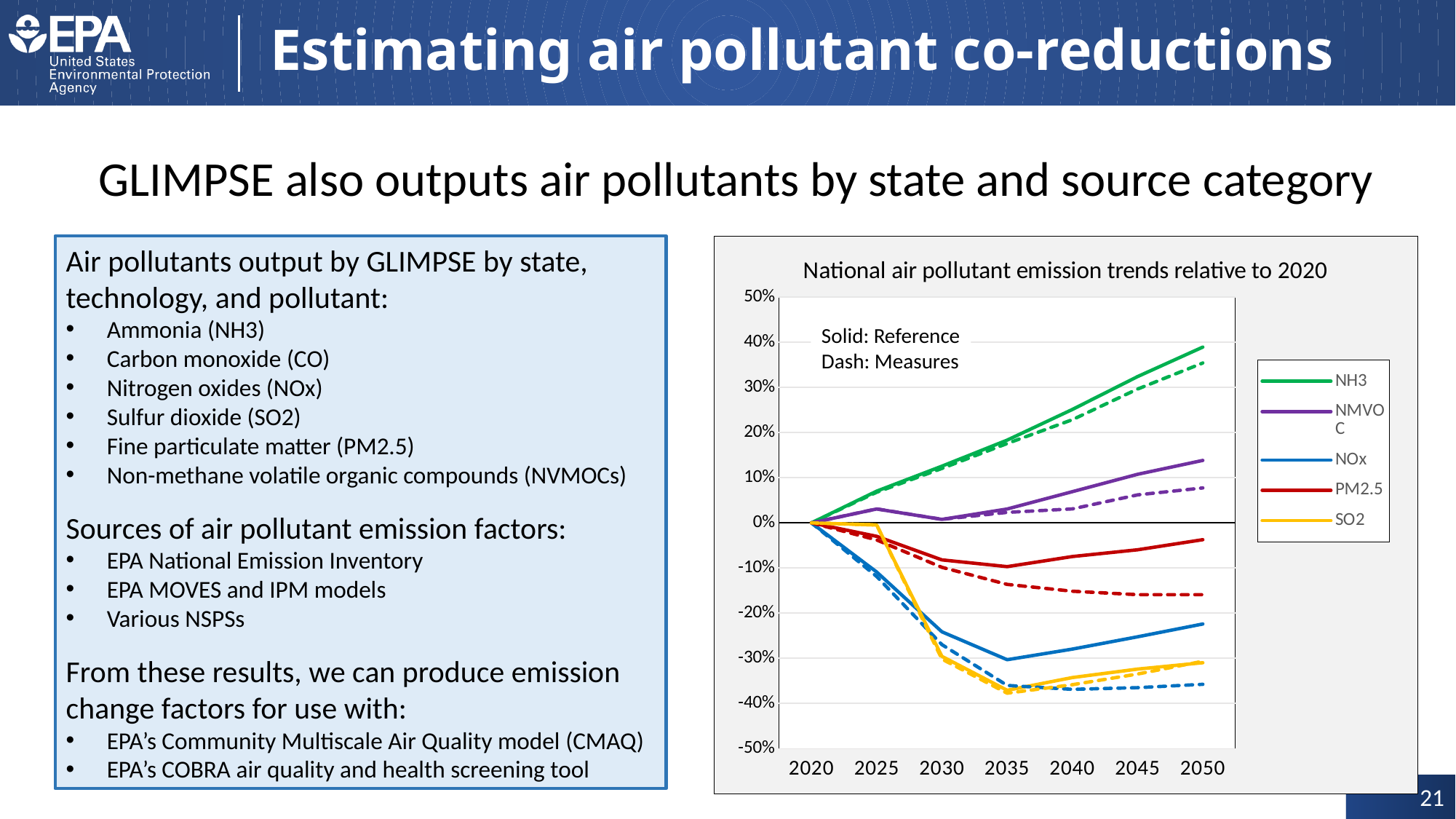
Does the solid NH3 line rise or fall from 2020 to 2050? Rises How many pollutants does the chart legend list? 5 Is the value of the solid PM2.5 line in 2050 greater or less than -10%? greater What kind of chart is shown on the slide? Line chart According to the chart annotation, what do the dashed lines represent? Measures Among the solid Reference lines, which pollutant has the highest value in 2050? NH3 Is the value of the solid NH3 line in 2050 greater or less than 30%? greater Is the value of the solid SO2 line in 2035 greater or less than -30%? less How many years are labelled on the x axis of the chart? 7 In 2050, is the solid PM2.5 line above or below the solid NOx line? Above Among the solid Reference lines, which pollutant has the lowest value in 2050? SO2 What is the title of the chart? National air pollutant emission trends relative to 2020